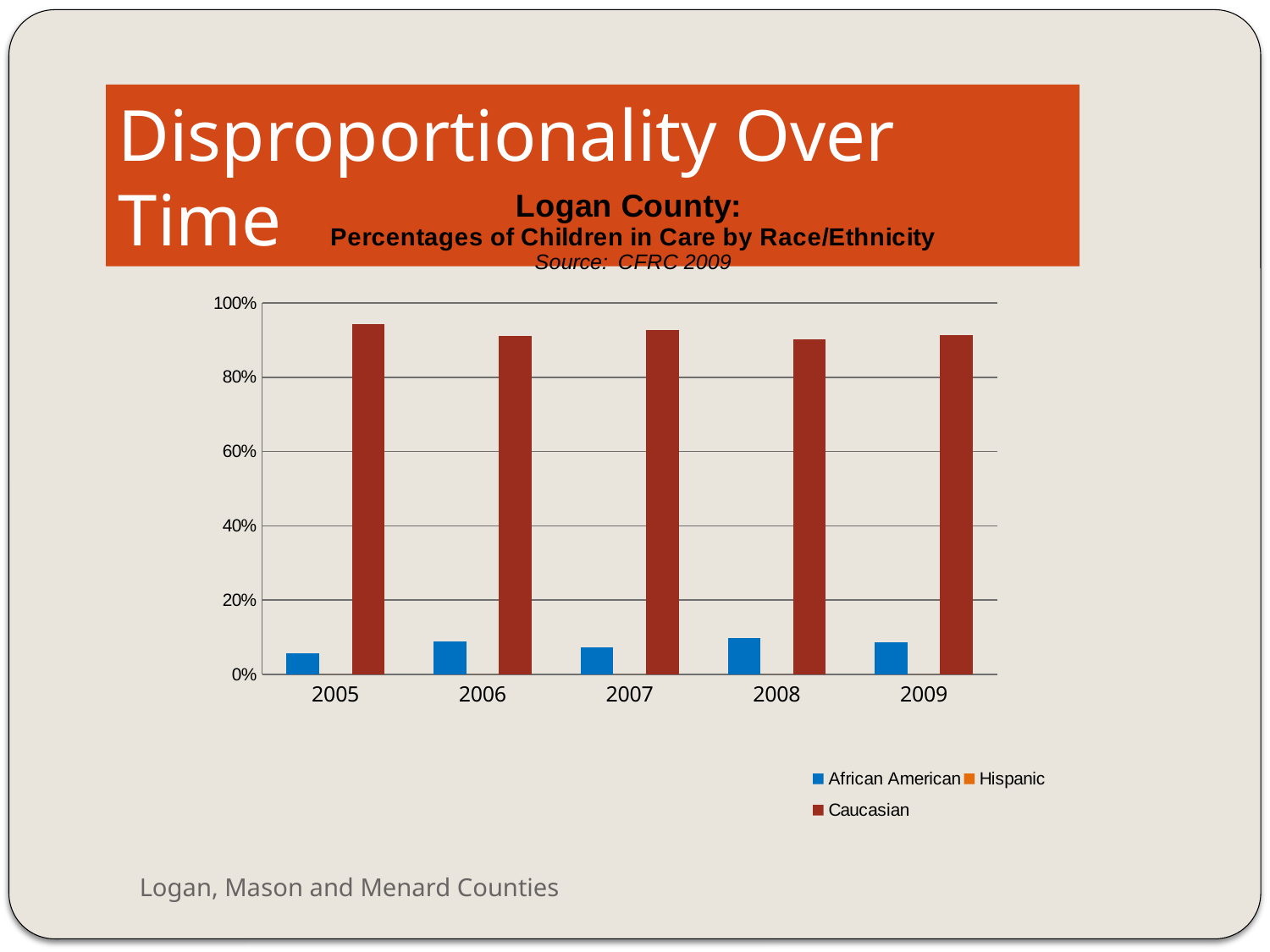
Which county does the chart's title say the data is for? Logan County Which is larger: the Caucasian value for 2005 or for 2008? 2005 How many series does the chart's legend list? 3 Which is larger: the African American value for 2008 or for 2005? 2008 In 2007, which is larger: the Caucasian value or the African American value? Caucasian How many years are shown on the x axis of the chart? 5 Is the African American value for 2005 greater or less than 20%? less Is the Caucasian value for 2005 greater or less than 80%? greater What source is cited under the chart's title? CFRC 2009 Is the Caucasian value for 2008 greater or less than 60%? greater What kind of chart is shown on the slide? bar chart